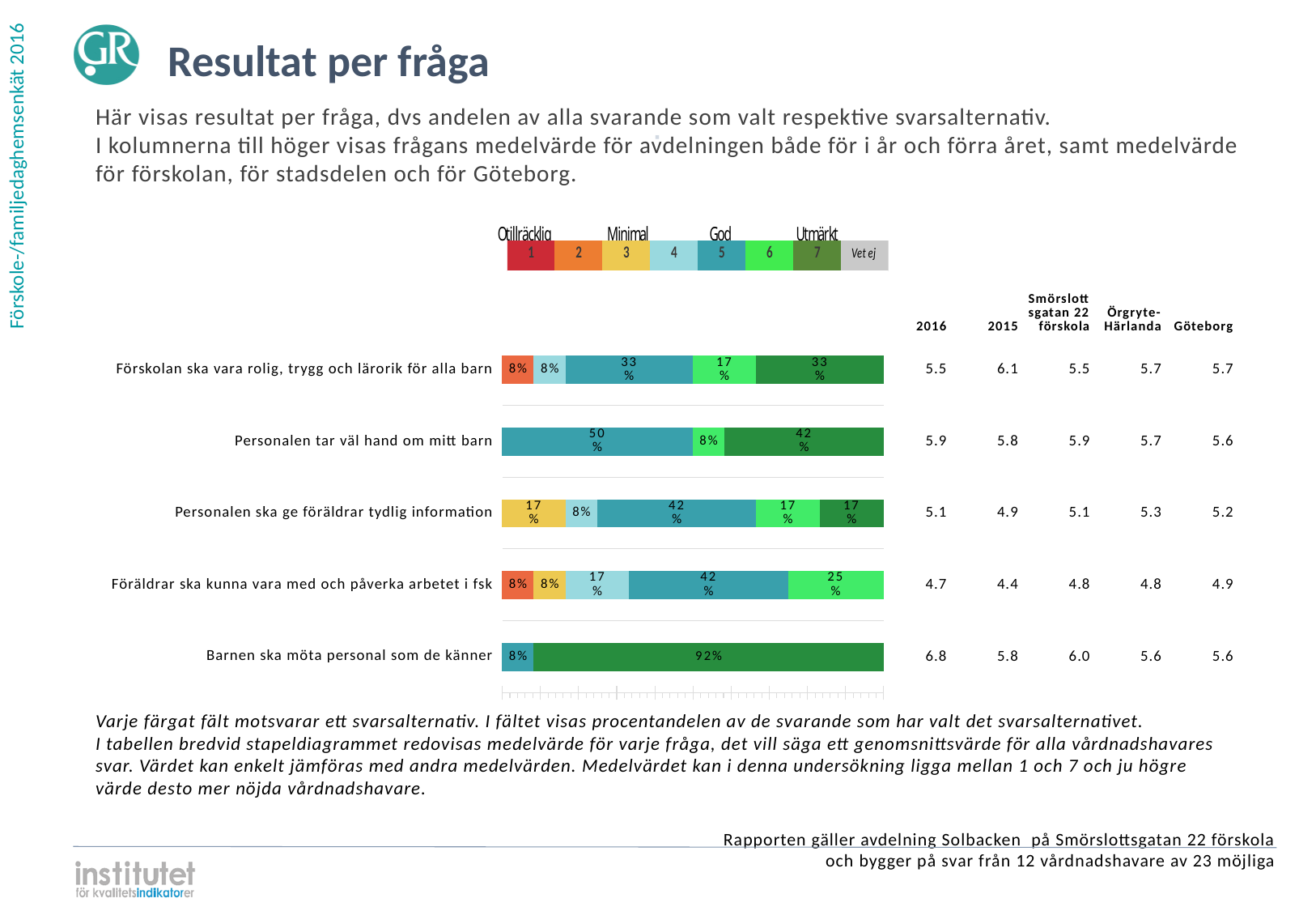
How many questions (categories) are plotted in the bar chart? 5 How many answer alternatives does the legend above the chart list, including 'Vet ej'? 8 What is the 2016 mean value shown for 'Barnen ska möta personal som de känner'? 6.8 For 'Föräldrar ska kunna vara med och påverka arbetet i fsk', which is larger: the share choosing alternative 5 or alternative 6? Alternative 5 What is the title of the slide? Resultat per fråga What is the Göteborg mean value shown for 'Föräldrar ska kunna vara med och påverka arbetet i fsk'? 4.9 What percentage chose alternative 3 (yellow) for 'Personalen ska ge föräldrar tydlig information'? 17% For 'Förskolan ska vara rolig, trygg och lärorik för alla barn', what is the difference between the share choosing alternative 7 and the share choosing alternative 6? 16% What percentage of respondents chose alternative 7 (dark green) for 'Barnen ska möta personal som de känner'? 92% Which question has the largest share of respondents choosing alternative 7 (dark green)? Barnen ska möta personal som de känner What kind of chart is shown on the slide? Stacked bar chart What percentage chose alternative 5 (teal) for 'Personalen tar väl hand om mitt barn'? 50%